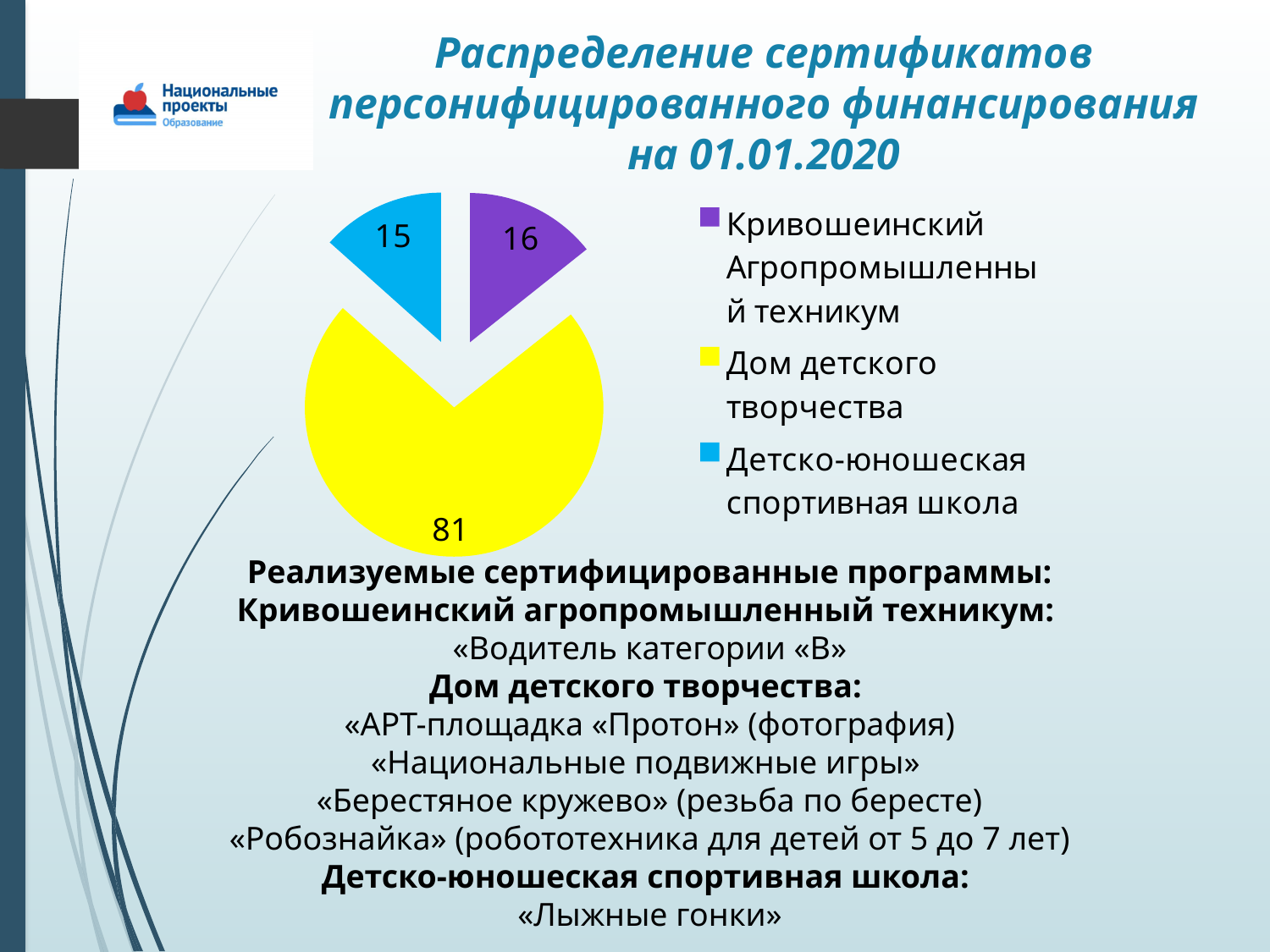
Which organisation has the largest slice of the pie? Дом детского творчества What is the total of all values shown in the pie chart? 112 Which is larger: the value for Кривошеинский Агропромышленный техникум or for Детско-юношеская спортивная школа? Кривошеинский Агропромышленный техникум Which organisation has the smallest slice of the pie? Детско-юношеская спортивная школа What value is shown for Кривошеинский Агропромышленный техникум? 16 What share of the total does Дом детского творчества represent? 72.3% How many certificates does the chart show for Дом детского творчества? 81 What kind of chart is shown on the slide? Pie chart How many slices does the pie chart have? 3 What colour is the slice for Дом детского творчества? Yellow What is the difference between the values for Дом детского творчества and Кривошеинский Агропромышленный техникум? 65 What value is shown for Детско-юношеская спортивная школа? 15